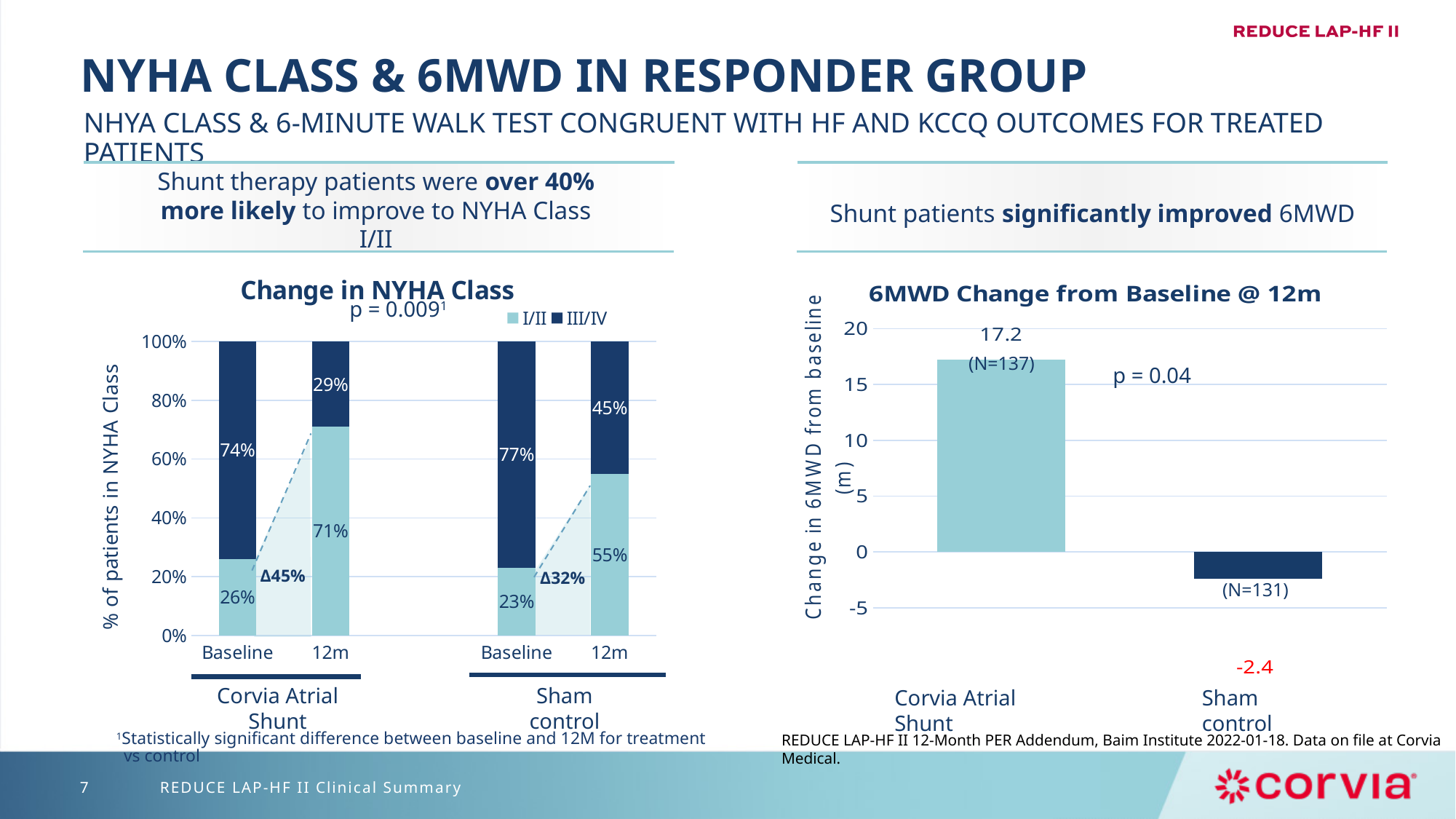
In the 'Change in NYHA Class' chart, what percentage of Sham control patients were in NYHA Class III/IV at baseline? 77% In the '6MWD Change from Baseline @ 12m' chart, what is the p-value shown? p = 0.04 In the '6MWD Change from Baseline @ 12m' chart, which group has the lowest value? Sham control In the 'Change in NYHA Class' chart, how many series does the legend list? 2 In the 'Change in NYHA Class' chart, what percentage of Sham control patients were in NYHA Class I/II at 12m? 55% In the '6MWD Change from Baseline @ 12m' chart, what is the value for Corvia Atrial Shunt? 17.2 In the 'Change in NYHA Class' chart, what percentage of Corvia Atrial Shunt patients were in NYHA Class I/II at 12m? 71% In the '6MWD Change from Baseline @ 12m' chart, what is the value for Sham control? -2.4 In the 'Change in NYHA Class' chart, what is the total of the stacked bar for Sham control at baseline? 100% What kind of chart is 'Change in NYHA Class'? Stacked bar chart In the 'Change in NYHA Class' chart, which group has the larger Class I/II share at 12m, Corvia Atrial Shunt or Sham control? Corvia Atrial Shunt In the 'Change in NYHA Class' chart, what is the difference between the Class I/II share at 12m and at baseline for the Corvia Atrial Shunt group? 45%